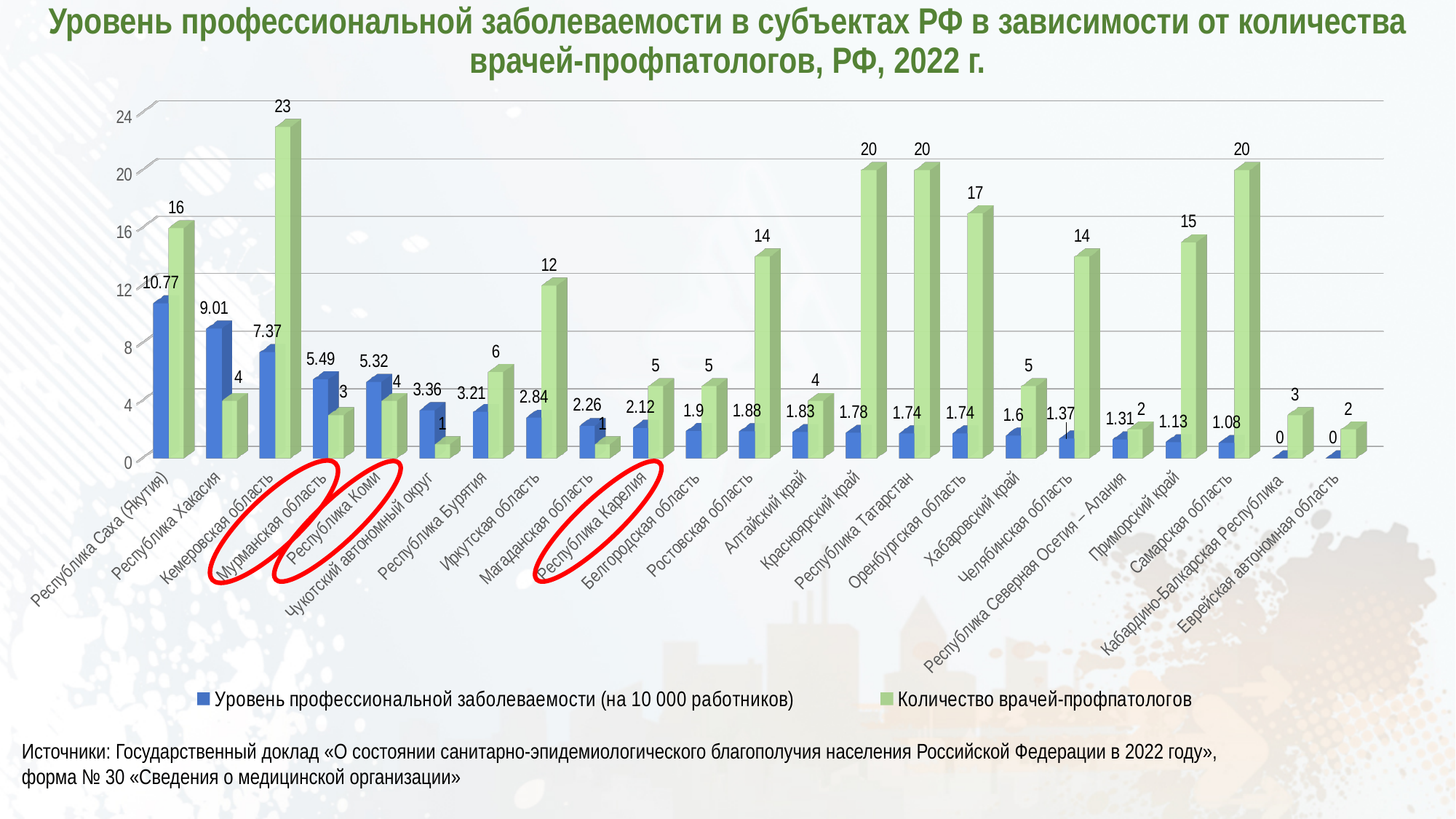
What is the difference in the number of occupational pathologists between Кемеровская область and Республика Саха (Якутия)? 7 Which region has the highest level of occupational morbidity? Республика Саха (Якутия) How many series does the legend list? 2 What is the level of occupational morbidity for Мурманская область? 5.49 What kind of chart is shown on the slide? Bar chart Which region has the highest number of occupational pathologists? Кемеровская область Which has more occupational pathologists: Иркутская область or Ростовская область? Ростовская область Do the blue bars (level of occupational morbidity) rise or fall from left to right along the x axis? Fall How many regions are shown on the x axis of the chart? 23 How many occupational pathologists (врачей-профпатологов) does Кемеровская область have? 23 Which colour represents the number of occupational pathologists in the chart? Green What is the level of occupational morbidity (per 10,000 workers) for Республика Саха (Якутия)? 10.77